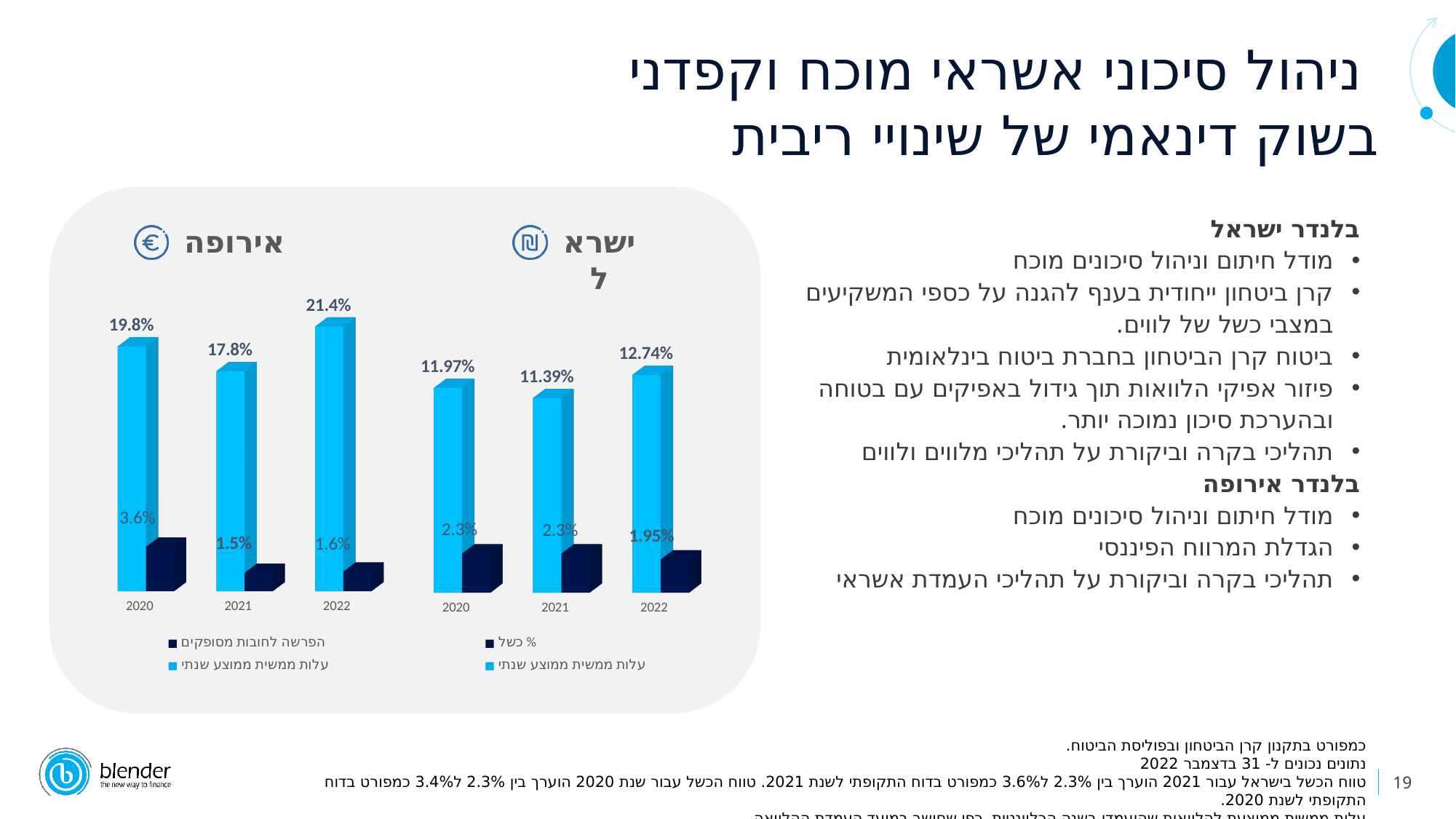
In the Israel (ישראל) chart, what is the annual average real cost (עלות ממשית ממוצע שנתי) value for 2020? 11.97% What type of chart is used for the Israel (ישראל) data? Bar chart How many years are shown on the x axis of the Israel (ישראל) chart? 3 In the Israel (ישראל) chart, which year has the lowest annual average real cost? 2021 In the Europe (אירופה) chart, what is the provision for doubtful debts (הפרשה לחובות מסופקים) for 2020? 3.6% In the Europe (אירופה) chart, what is the annual average real cost (עלות ממשית ממוצע שנתי) value for 2022? 21.4% In the Europe (אירופה) chart, what is the difference between the annual average real cost in 2022 and in 2021? 3.6% In the Europe (אירופה) chart, which year has the highest annual average real cost? 2022 Which is larger: the 2020 annual average real cost in the Europe chart or in the Israel chart? Europe (19.8%) How many series does the legend of the Europe (אירופה) chart list? 2 In the Israel (ישראל) chart, what is the default rate (% כשל) for 2022? 1.95% In the Israel (ישראל) chart, what is the difference between the annual average real cost in 2022 and in 2020? 0.77%